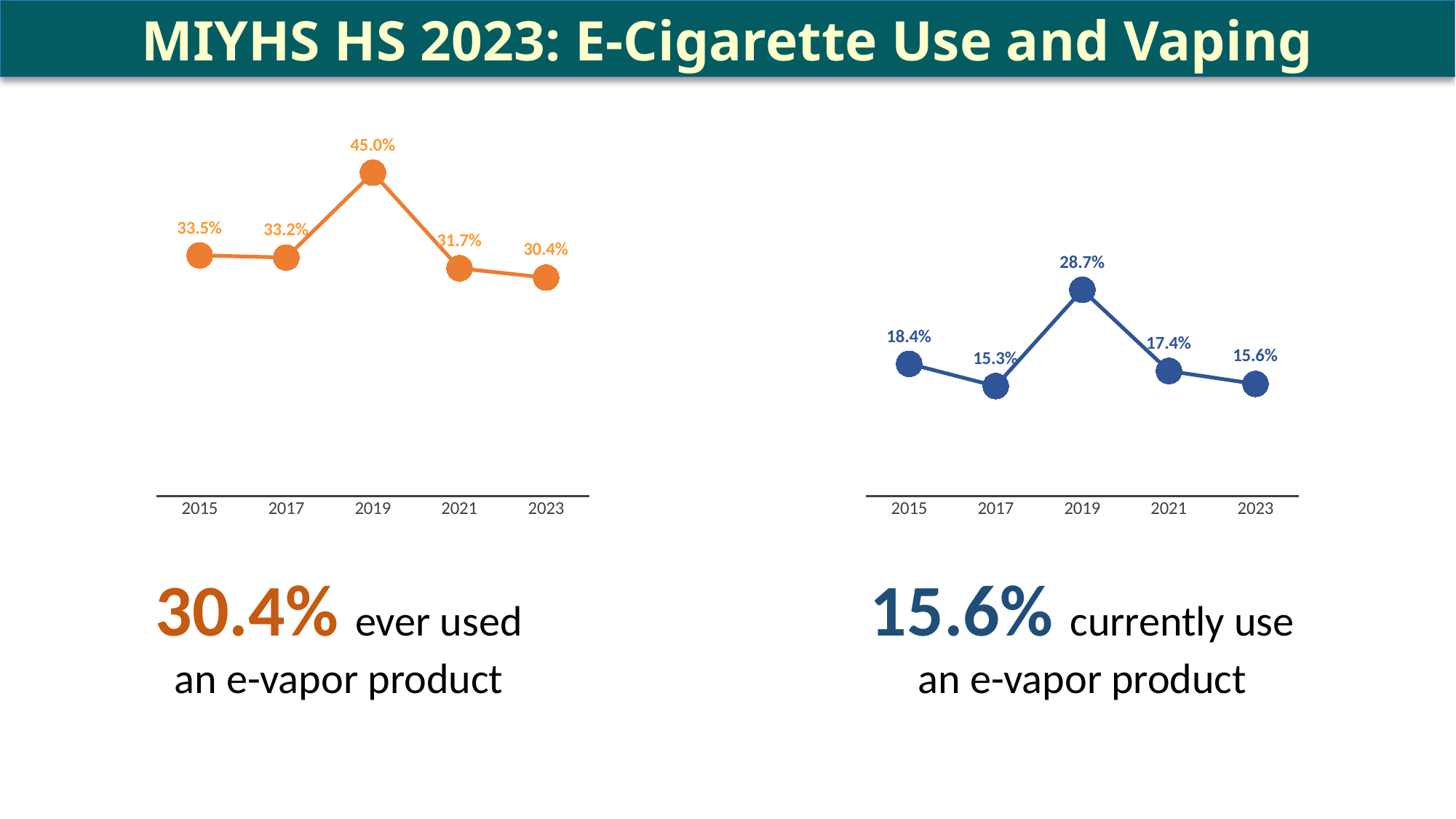
What kind of chart is the right chart (currently use an e-vapor product)? line chart In the left chart (ever used an e-vapor product), what is the value for 2019? 45.0% In the right chart (currently use an e-vapor product), what is the difference between the 2015 value and the 2023 value? 2.8% In the left chart (ever used an e-vapor product), what is the difference between the 2019 value and the 2023 value? 14.6% What colour is the line in the right chart (currently use an e-vapor product)? blue How many data points are plotted in the left chart (ever used an e-vapor product)? 5 In the right chart (currently use an e-vapor product), which is larger, the value for 2015 or the value for 2021? 2015 In the right chart (currently use an e-vapor product), what is the value for 2017? 15.3% In the left chart (ever used an e-vapor product), which year has the highest value? 2019 In the right chart (currently use an e-vapor product), which year has the lowest value? 2017 In the left chart (ever used an e-vapor product), do the values rise or fall from 2019 to 2023? fall In the left chart (ever used an e-vapor product), what is the value for 2015? 33.5%